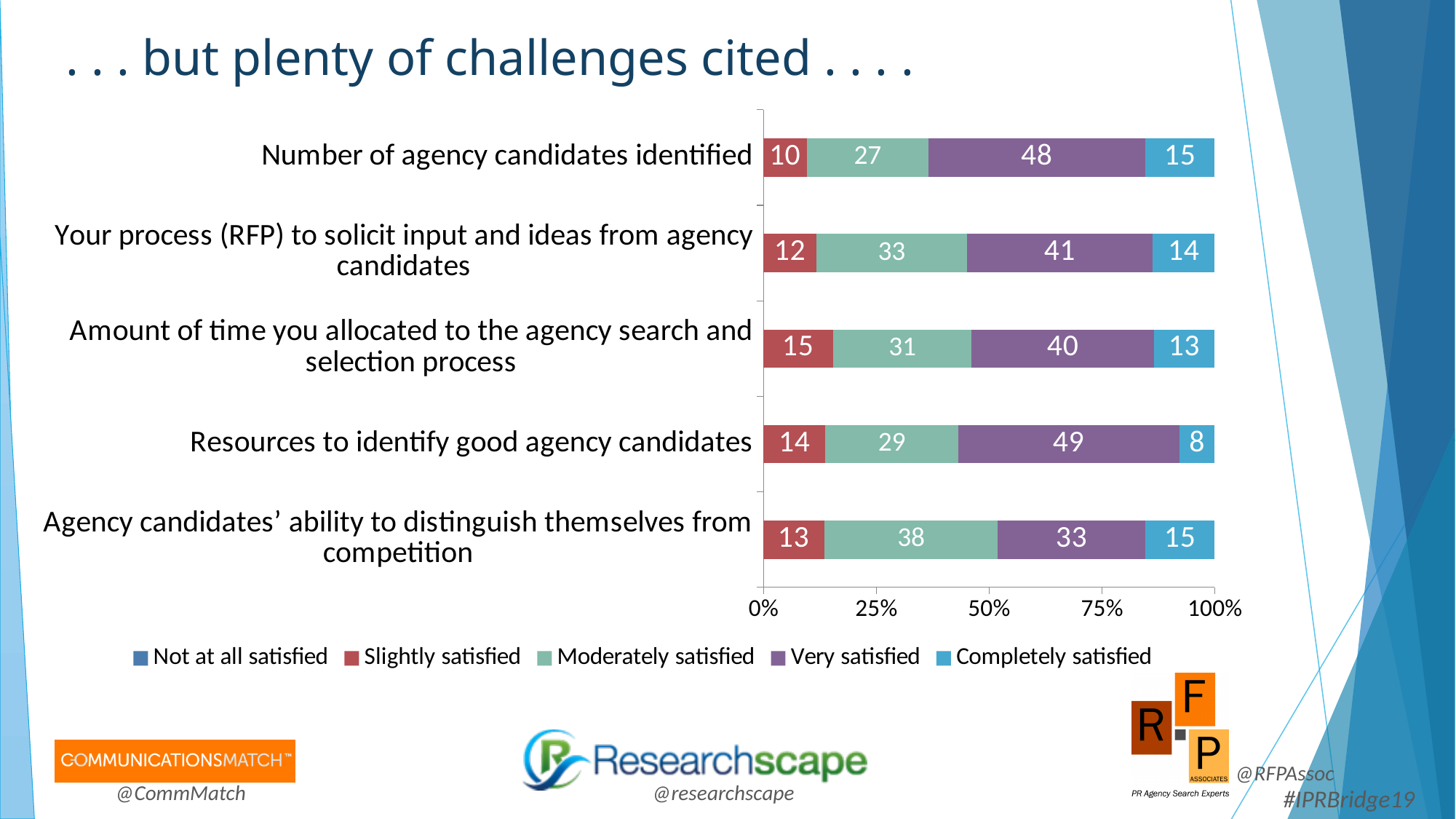
What is the Slightly satisfied value for "Amount of time you allocated to the agency search and selection process"? 15 What is the Moderately satisfied value for "Your process (RFP) to solicit input and ideas from agency candidates"? 33 What is the Completely satisfied value for "Resources to identify good agency candidates"? 8 Which category has the highest Very satisfied value? Resources to identify good agency candidates How many series does the legend list? 5 What is the Very satisfied value for "Number of agency candidates identified"? 48 What kind of chart is shown on the slide? Stacked bar chart Which has a larger Very satisfied value: "Your process (RFP) to solicit input and ideas from agency candidates" or "Amount of time you allocated to the agency search and selection process"? Your process (RFP) to solicit input and ideas from agency candidates Which category has the highest Slightly satisfied value? Amount of time you allocated to the agency search and selection process How many categories are shown on the chart? 5 Which category has the lowest Completely satisfied value? Resources to identify good agency candidates What is the difference between the Moderately satisfied values for "Agency candidates' ability to distinguish themselves from competition" and "Number of agency candidates identified"? 11